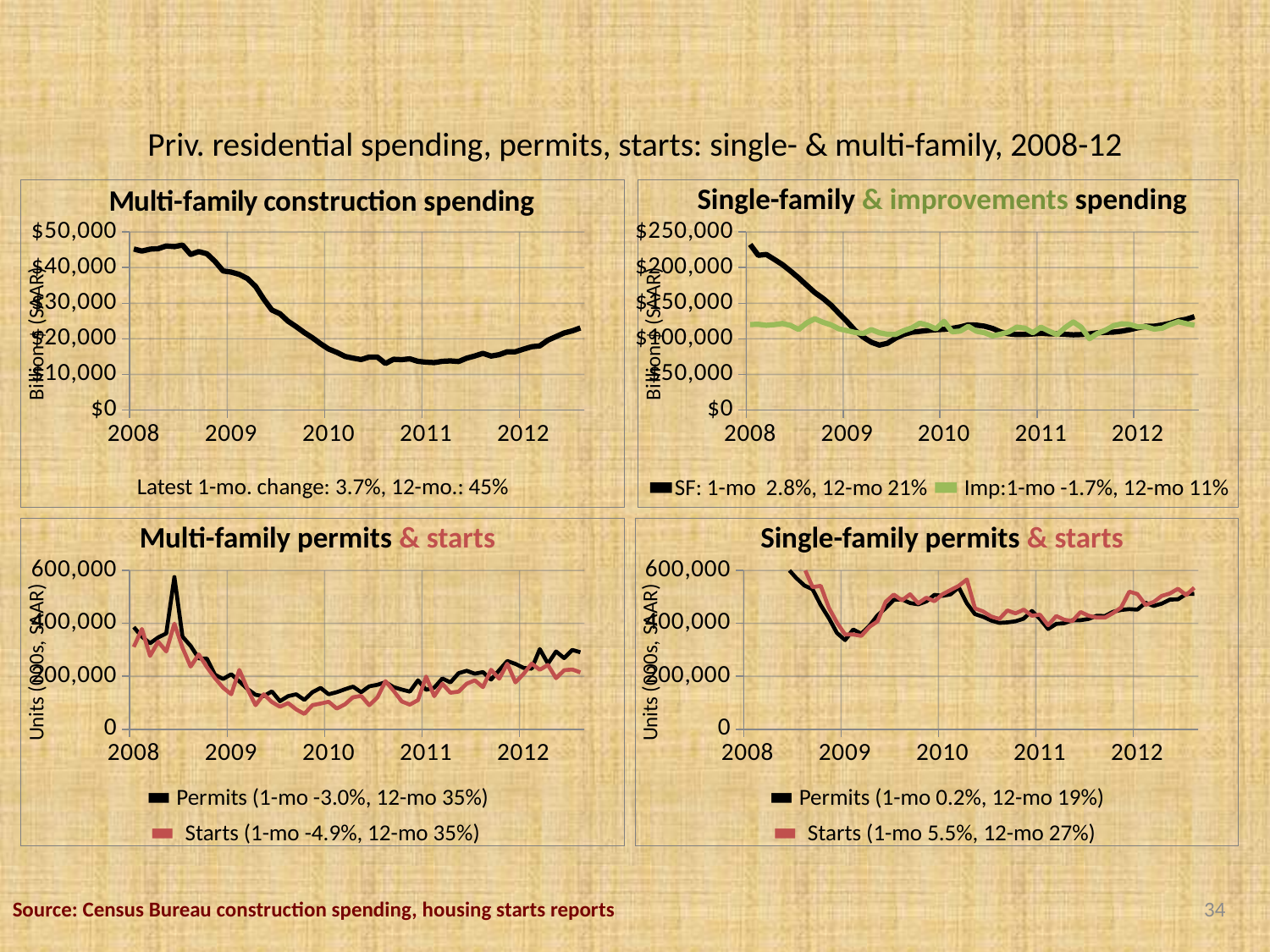
In the 'Multi-family construction spending' chart, do values rise or fall from 2011 to the end of 2012? rise In the 'Multi-family permits & starts' chart, is the peak of the Permits line in 2008 greater or less than 400,000? greater In the 'Multi-family construction spending' chart, is the value at the start of 2008 greater or less than $40,000? greater In the 'Single-family & improvements spending' chart, which series is higher at the start of 2008, SF or Imp? SF What kind of chart is the 'Multi-family construction spending' chart? line chart How many series does the legend of the 'Single-family & improvements spending' chart list? 2 In the 'Multi-family permits & starts' chart, what is the legend entry for the Starts series? Starts (1-mo -4.9%, 12-mo 35%) How many series does the legend of the 'Multi-family permits & starts' chart list? 2 In the 'Single-family & improvements spending' chart, is the SF value at the start of 2008 greater or less than $200,000? greater In the 'Multi-family construction spending' chart, do values rise or fall from 2008 to 2010? fall According to the text below the 'Multi-family construction spending' chart, what is the latest 1-month change? 3.7%